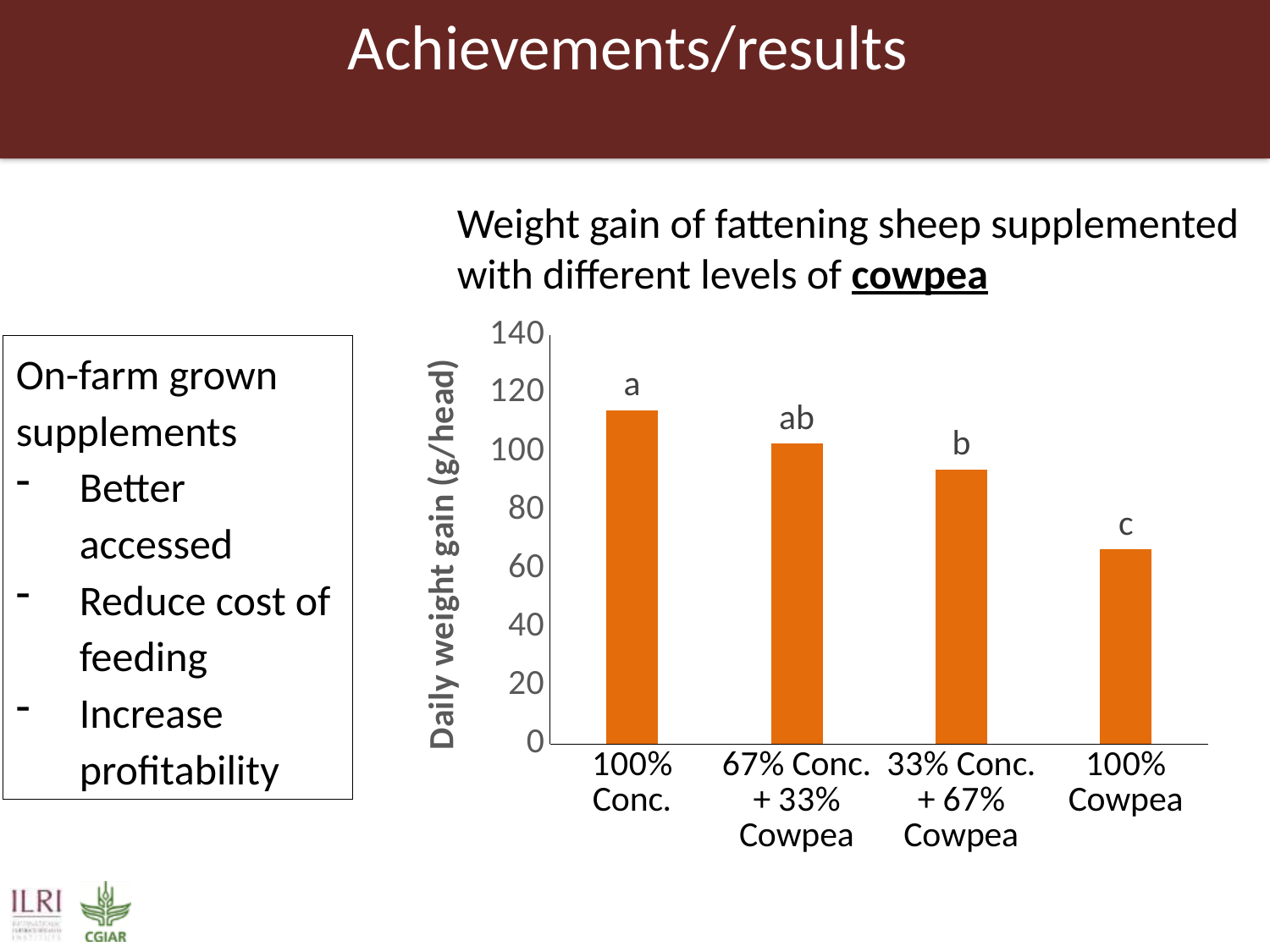
How many categories (bars) are shown in the chart? 4 What is the label of the y axis of the chart? Daily weight gain (g/head) Which has a higher daily weight gain: 67% Conc. + 33% Cowpea or 33% Conc. + 67% Cowpea? 67% Conc. + 33% Cowpea Which category has the lowest daily weight gain? 100% Cowpea What letter is printed above the bar for 100% Cowpea? c Do the daily weight gain values rise or fall as the share of cowpea increases from left to right along the x axis? fall What kind of chart is shown on the slide? bar chart Which category has the highest daily weight gain? 100% Conc. Is the value for 100% Cowpea greater or less than 80? less Is the value for 33% Conc. + 67% Cowpea greater or less than 100? less Is the value for 100% Conc. greater or less than 100? greater